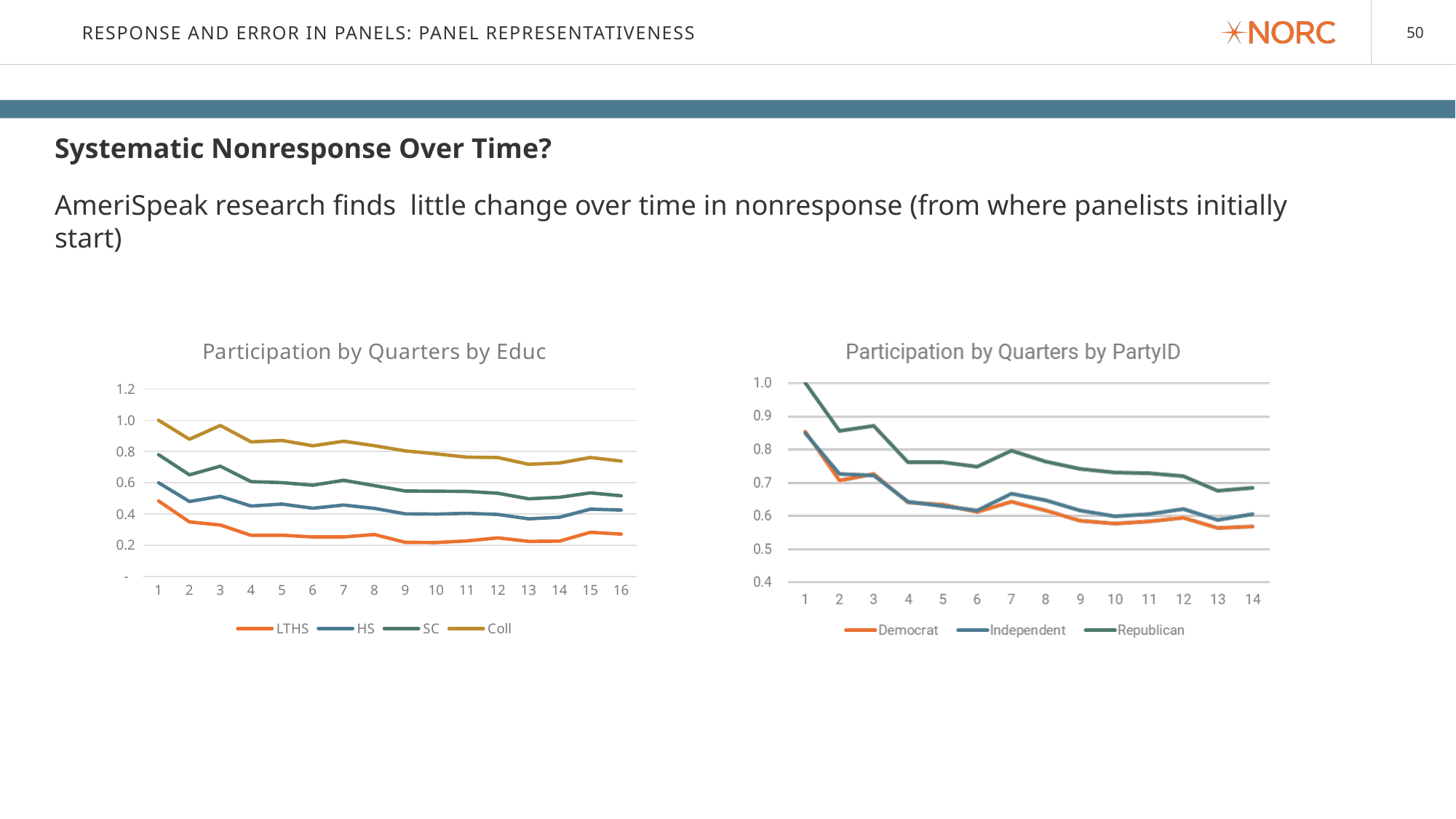
What type of chart is "Participation by Quarters by Educ"? line chart How many series does the legend of "Participation by Quarters by Educ" list? 4 How many quarters are shown on the x axis of "Participation by Quarters by PartyID"? 14 In "Participation by Quarters by Educ", which series has the highest participation across the quarters? Coll In "Participation by Quarters by Educ", what is the value for Coll at quarter 1? 1.0 In "Participation by Quarters by Educ", is the value for LTHS at quarter 16 greater or less than 0.4? less In "Participation by Quarters by Educ", which series has the lowest participation across the quarters? LTHS How many quarters are shown on the x axis of "Participation by Quarters by Educ"? 16 In "Participation by Quarters by Educ", does the Coll line generally rise or fall from quarter 1 to quarter 16? fall How many series does the legend of "Participation by Quarters by PartyID" list? 3 In "Participation by Quarters by PartyID", is the value for Republican at quarter 14 greater or less than 0.6? greater In "Participation by Quarters by PartyID", what is the value for Republican at quarter 1? 1.0